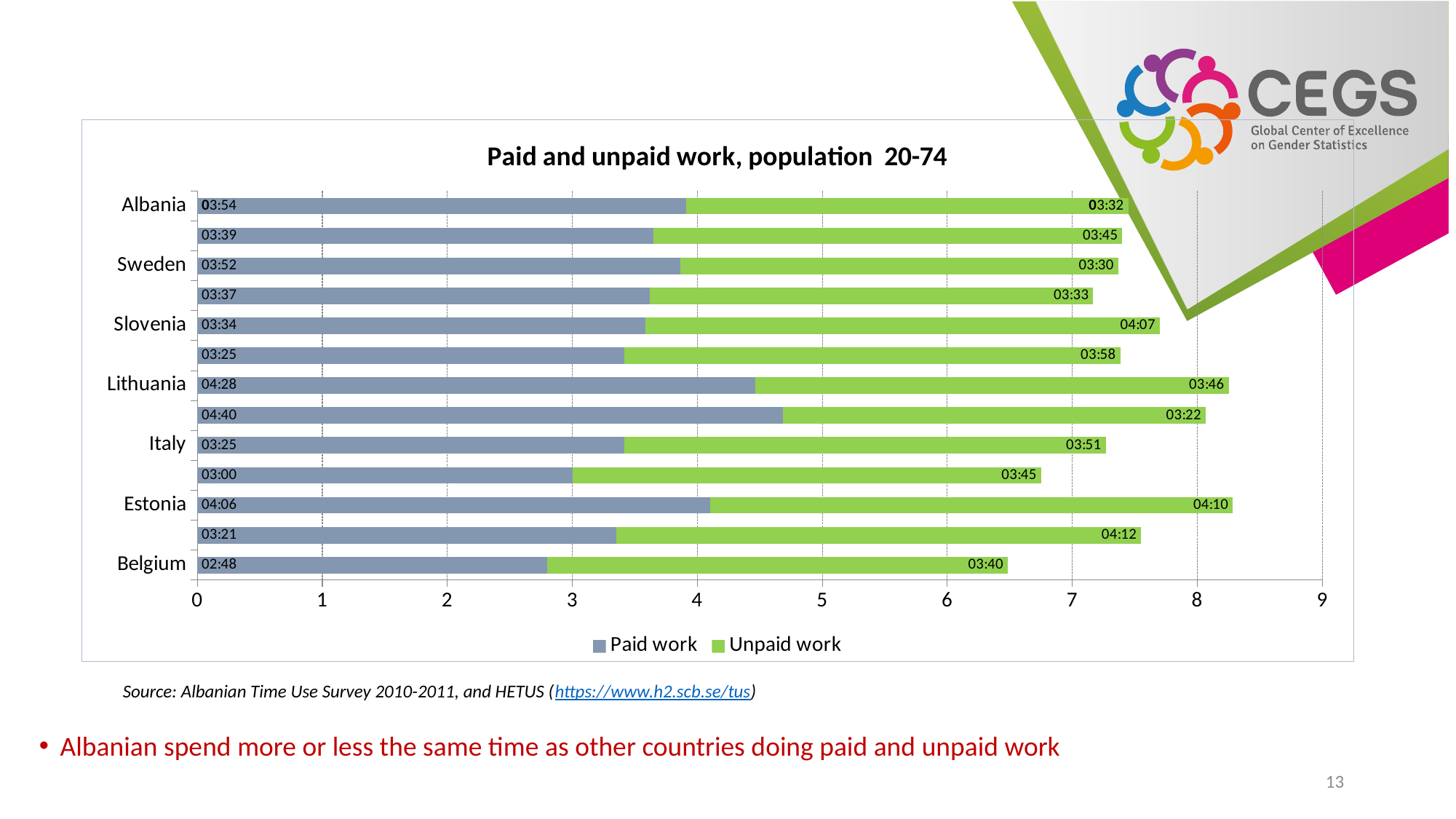
What kind of chart is shown? Stacked bar chart Is the total length of the Belgium bar greater or less than 7? less Which country has the lowest paid work value? Belgium What is the title of the chart? Paid and unpaid work, population 20-74 Is the total length of the Lithuania bar greater or less than 8? greater What is the paid work value for Lithuania? 04:28 What is the unpaid work value for Belgium? 03:40 What is the unpaid work value for Slovenia? 04:07 What is the paid work value for Albania? 03:54 Which is larger, the unpaid work value for Estonia or for Sweden? Estonia Which is larger, the paid work value for Lithuania or for Italy? Lithuania How many series does the legend list? 2